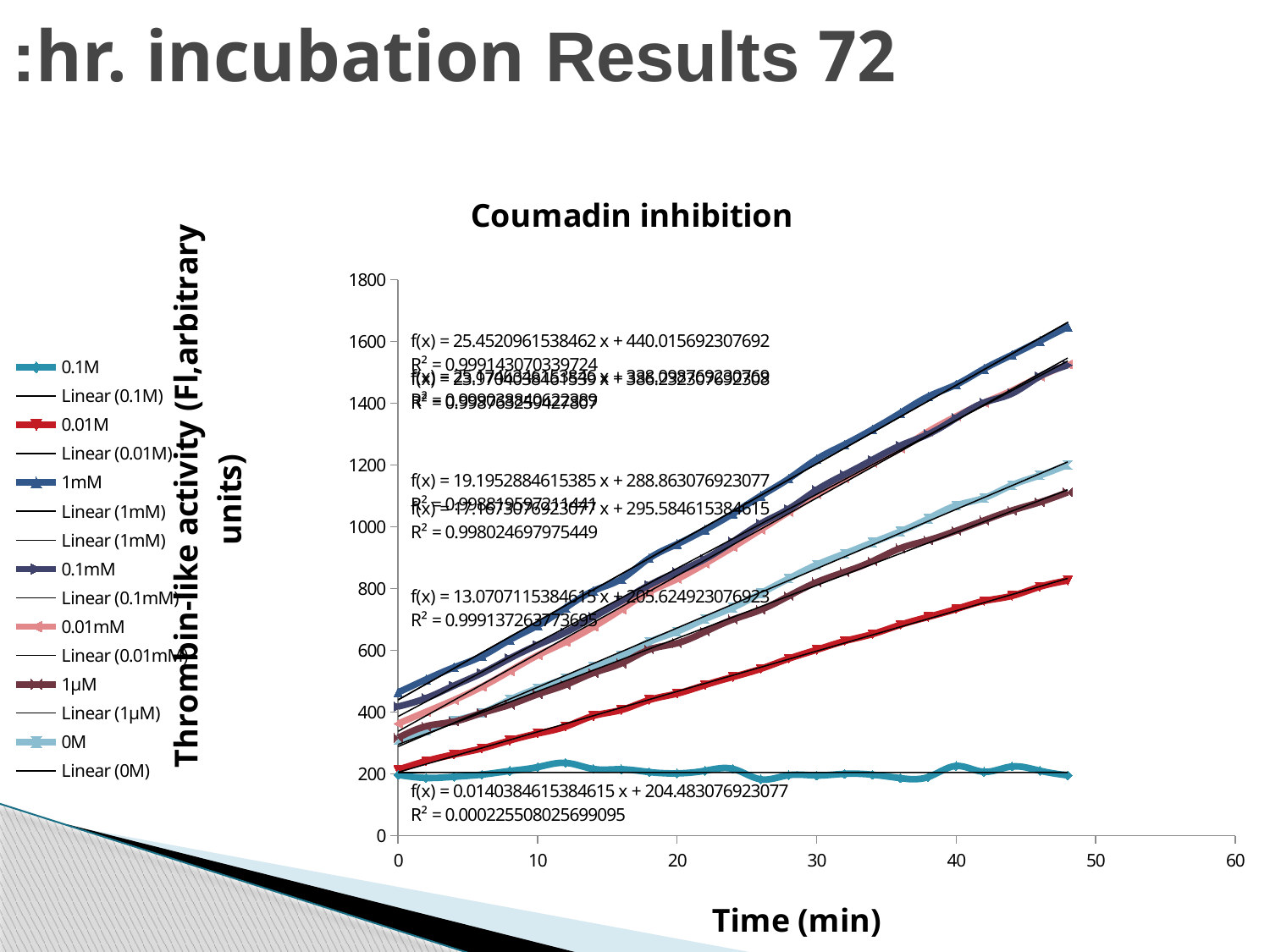
At 48 minutes, which is larger: the value for 0.01M or the value for 0M? 0M What is the title of the chart? Coumadin inhibition Is the value for the 0.1M series at 48 minutes greater or less than 400? less Which series has the highest value at 48 minutes? 1mM How many entries does the chart's legend list? 15 Is the value for the 0M series at 48 minutes greater or less than 1000? greater What is the label of the x axis of the chart? Time (min) What kind of chart is shown on the slide? line chart Which series has the lowest value at 48 minutes? 0.1M Does the 0.1M series rise, fall, or stay roughly flat as time increases? stays roughly flat Does the 0M series rise or fall as time increases? rises What R² value is printed for the trendline of the flat series at the bottom of the chart? 0.000225508025699095